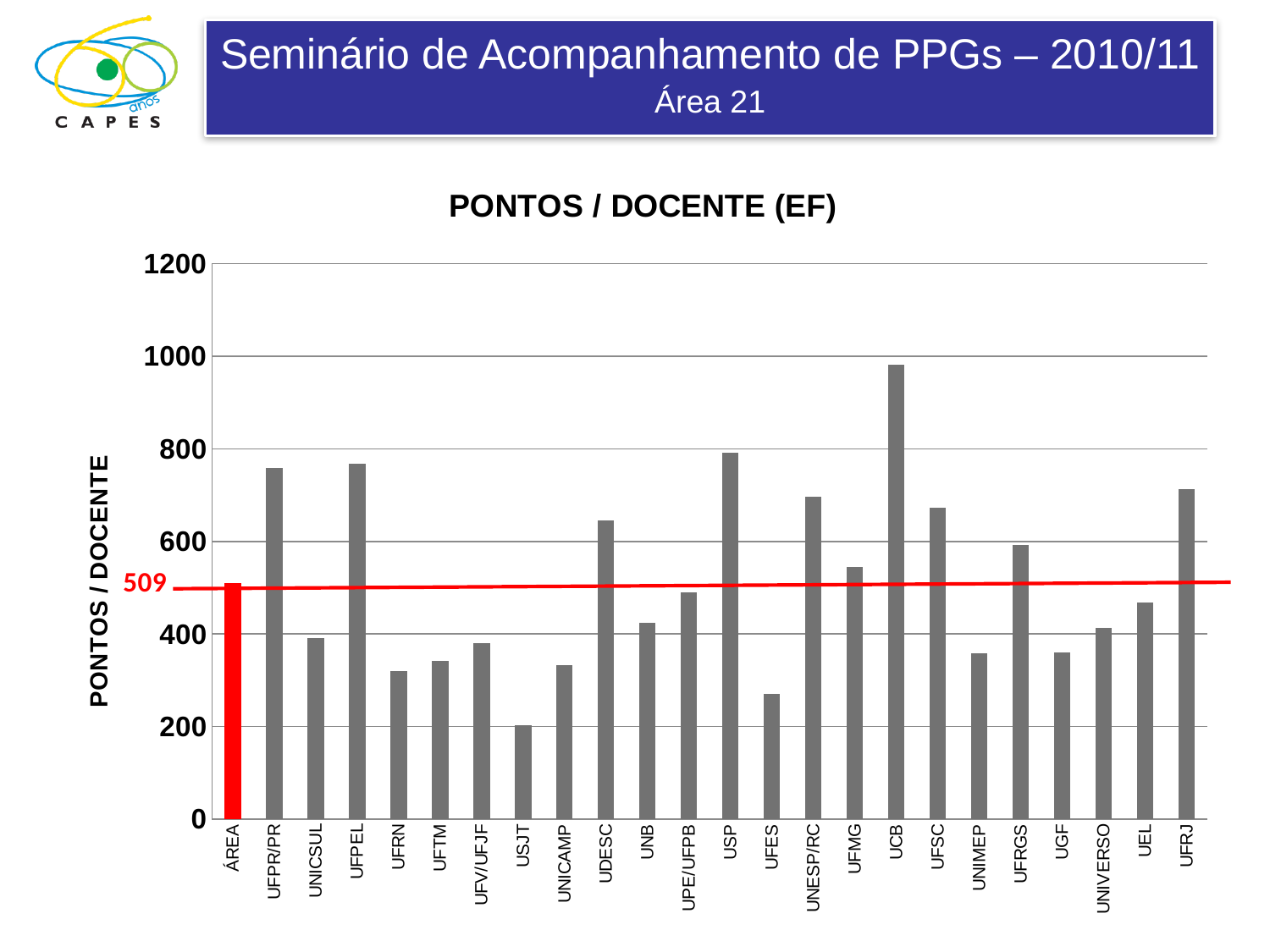
Which category has the highest value? UCB Is the value for UFES greater or less than 400? less How many categories are shown on the x axis? 24 Is the value for USP greater or less than 600? greater What is the label of the vertical axis? PONTOS / DOCENTE What kind of chart is shown on the slide? bar chart Which category has the lowest value? USJT Is the value for UCB greater or less than 800? greater What value is marked for ÁREA by the red line? 509 What is the title of the chart? PONTOS / DOCENTE (EF) Which is larger, the value for UDESC or the value for UNB? UDESC